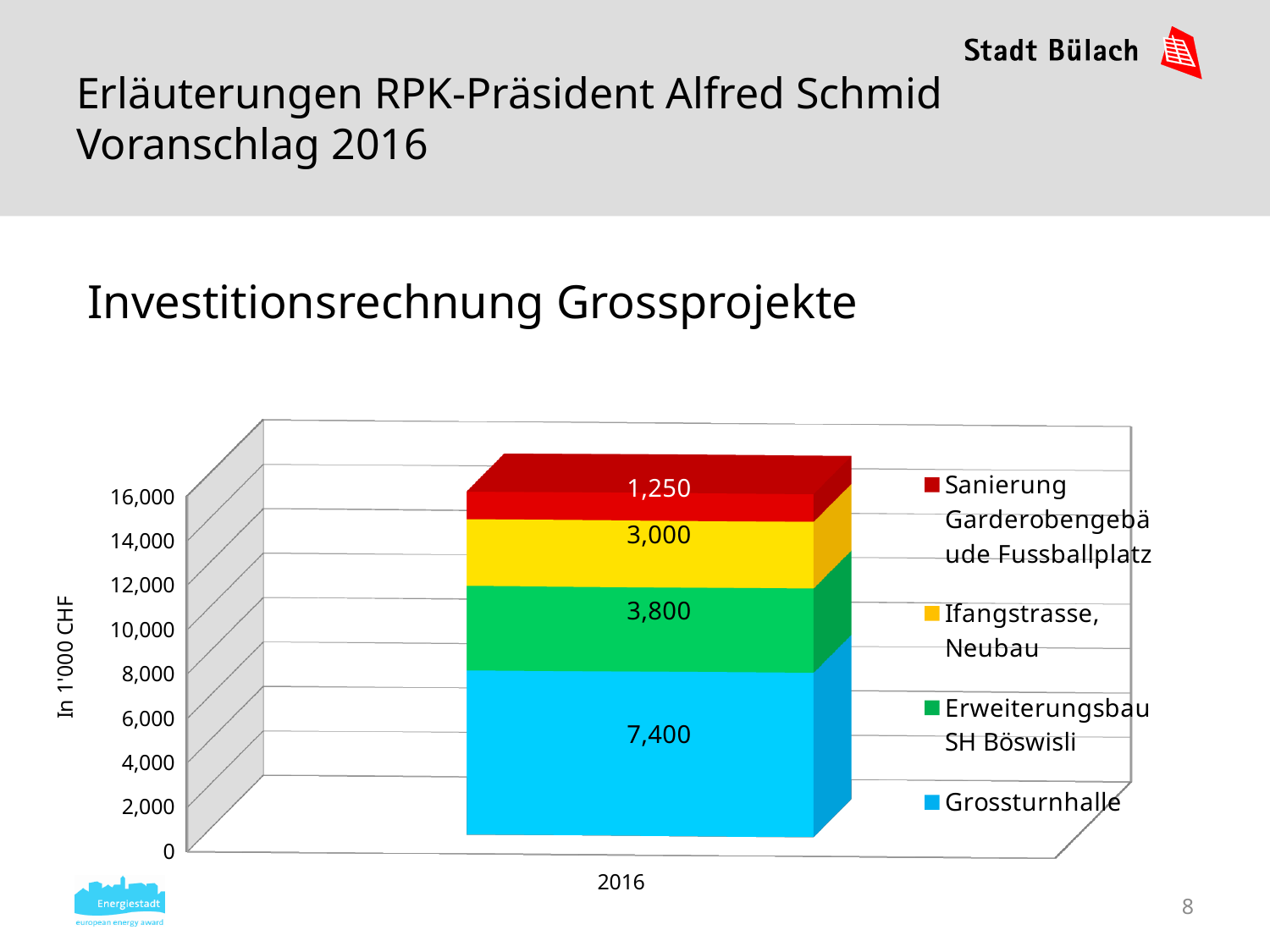
Which is larger, the value for Ifangstrasse, Neubau or the value for Sanierung Garderobengebäude Fussballplatz? Ifangstrasse, Neubau What is the value for Ifangstrasse, Neubau in 2016? 3,000 What is the total of the stacked bar for 2016? 15,450 What is the value for Grossturnhalle in 2016? 7,400 Which series has the lowest value in the 2016 bar? Sanierung Garderobengebäude Fussballplatz What is the difference between the values for Grossturnhalle and Erweiterungsbau SH Böswisli? 3,600 What unit is given on the vertical axis label of the chart? In 1'000 CHF What is the value for Erweiterungsbau SH Böswisli in 2016? 3,800 What is the value for Sanierung Garderobengebäude Fussballplatz in 2016? 1,250 Which series has the highest value in the 2016 bar? Grossturnhalle What kind of chart is shown on the slide? Stacked bar chart How many series does the legend list? 4